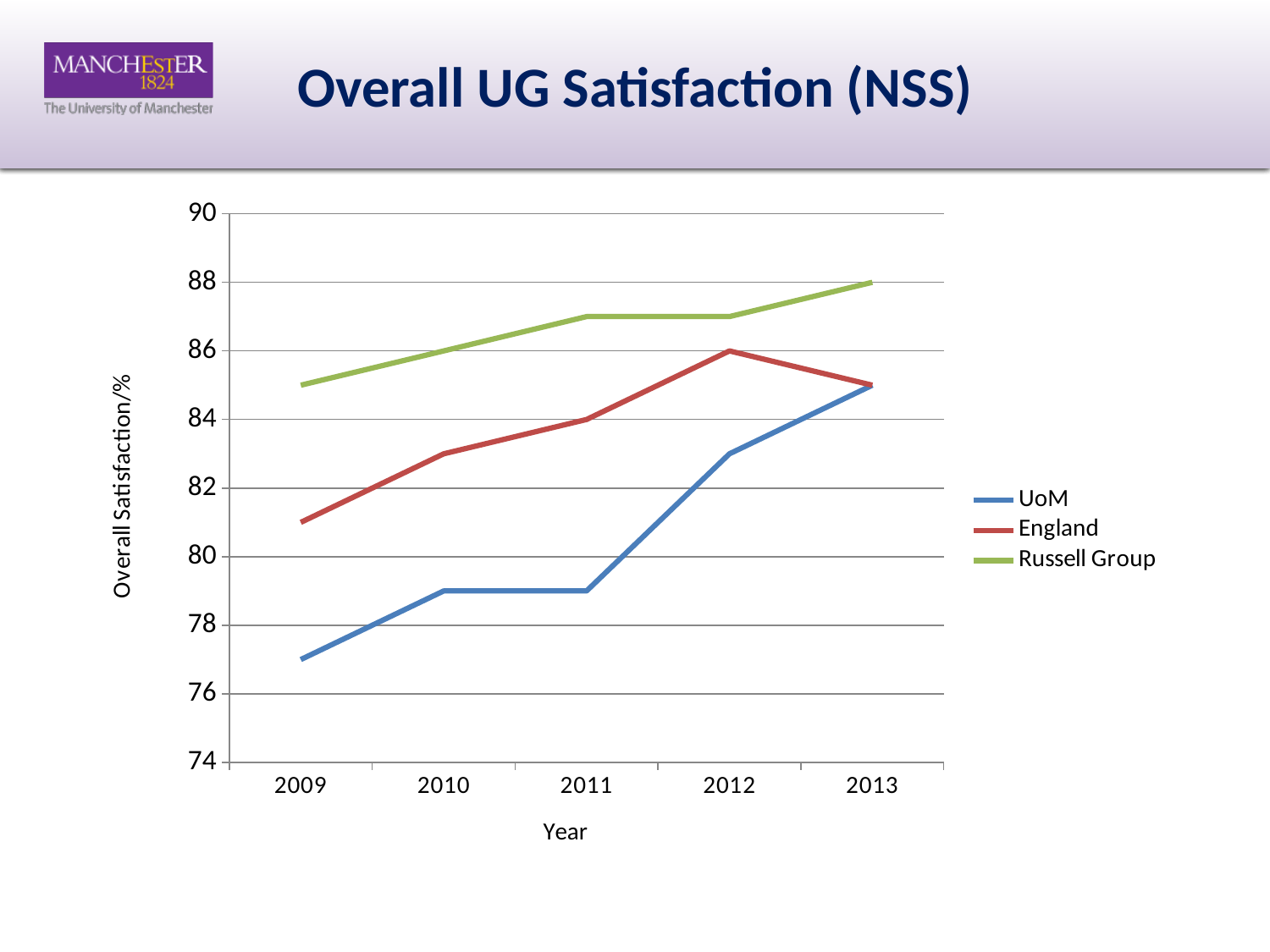
What is the England value for 2011? 84 What is the England value for 2012? 86 Is the Russell Group value for 2009 greater or less than 84? greater Does the UoM line rise or fall from 2009 to 2013? rise What is the Russell Group value for 2013? 88 How many series does the legend list? 3 Is the UoM value for 2009 greater or less than 78? less Which series has the lowest value in 2009? UoM In 2012, which is larger, the England value or the UoM value? England Which series has the highest value in 2013? Russell Group How many years are plotted along the x axis? 5 What kind of chart is shown on the slide? line chart